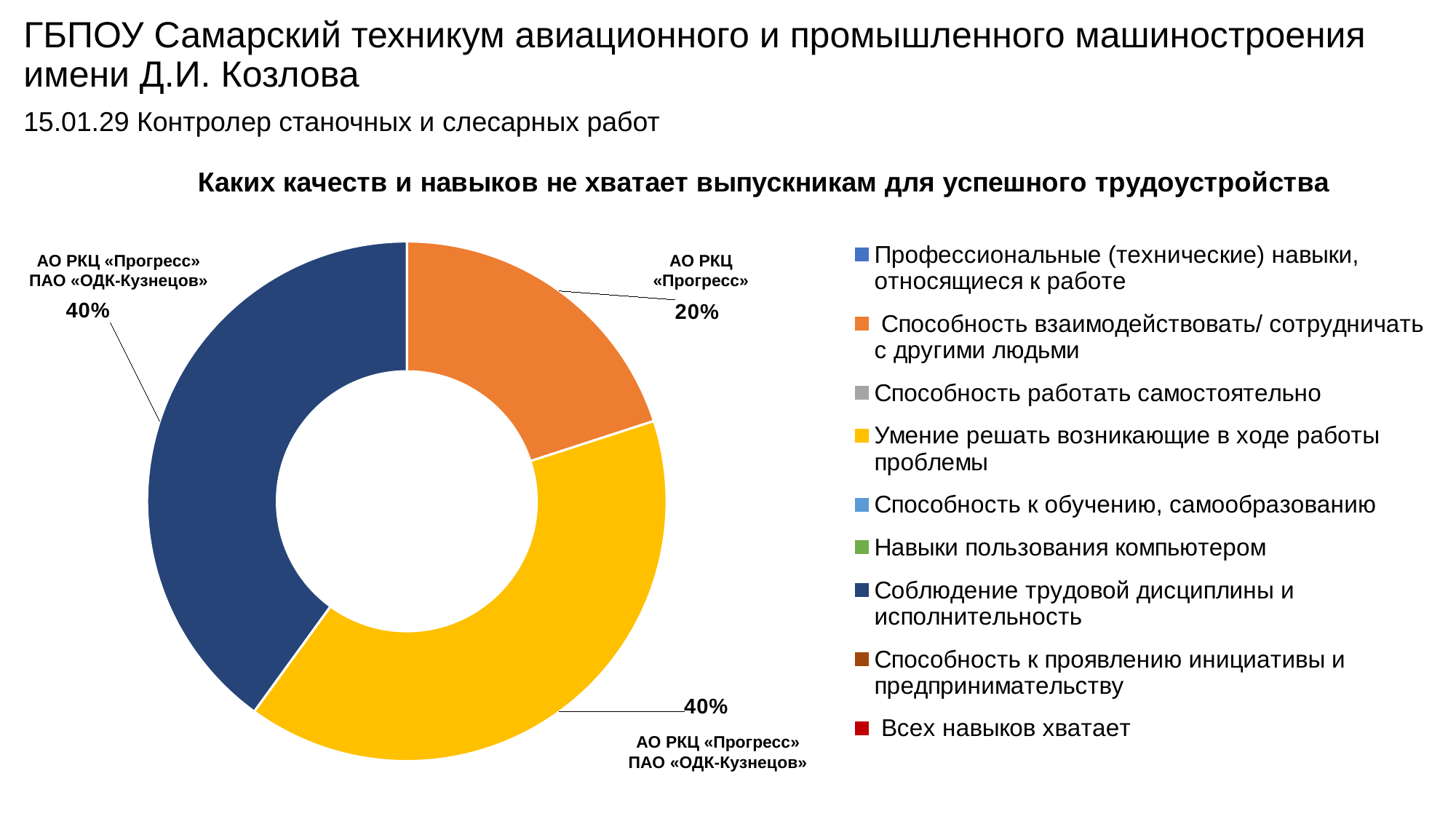
What percentage is shown for the dark blue slice, «Соблюдение трудовой дисциплины и исполнительность»? 40% How many slices with non-zero values are visible in the doughnut chart? 3 Which is larger: the slice for «Умение решать возникающие в ходе работы проблемы» or the slice for «Способность взаимодействовать/ сотрудничать с другими людьми»? Умение решать возникающие в ходе работы проблемы What is the combined share of the two 40% slices? 80% Which category has the smallest slice in the chart? Способность взаимодействовать/ сотрудничать с другими людьми What kind of chart is shown on the slide? Doughnut (pie) chart What percentage is shown for the orange slice, «Способность взаимодействовать/ сотрудничать с другими людьми»? 20% What percentage is shown for the yellow slice, «Умение решать возникающие в ходе работы проблемы»? 40% How many entries does the legend list? 9 What is the title of the chart? Каких качеств и навыков не хватает выпускникам для успешного трудоустройства Which employers are named in the data label next to the 20% slice? АО РКЦ «Прогресс» What is the difference between the yellow slice (40%) and the orange slice (20%)? 20%